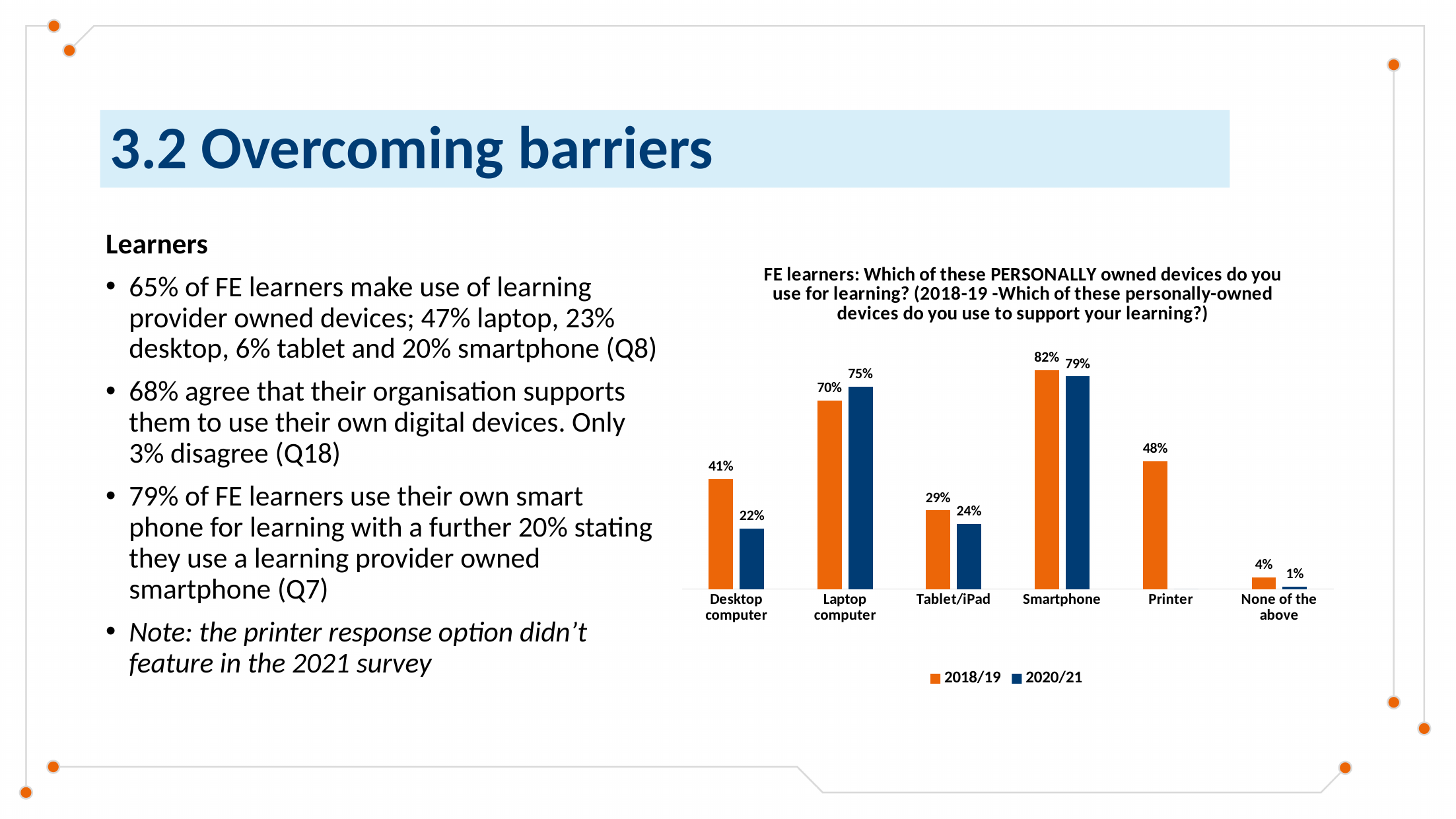
What percentage of FE learners used a personally owned smartphone for learning in 2020/21? 79% How many series does the legend list? 2 Which is larger for Laptop computer: the 2018/19 value or the 2020/21 value? 2020/21 By how many percentage points did the Desktop computer value fall from 2018/19 to 2020/21? 19 percentage points What is the 2020/21 value for Tablet/iPad? 24% What is the 2018/19 value for Desktop computer? 41% What is the 2018/19 value for Printer? 48% What type of chart is shown on the slide? Bar chart Which colour represents the 2020/21 series in the chart? Dark blue Which device has the highest value in the 2018/19 series? Smartphone How many device categories are shown on the x axis? 6